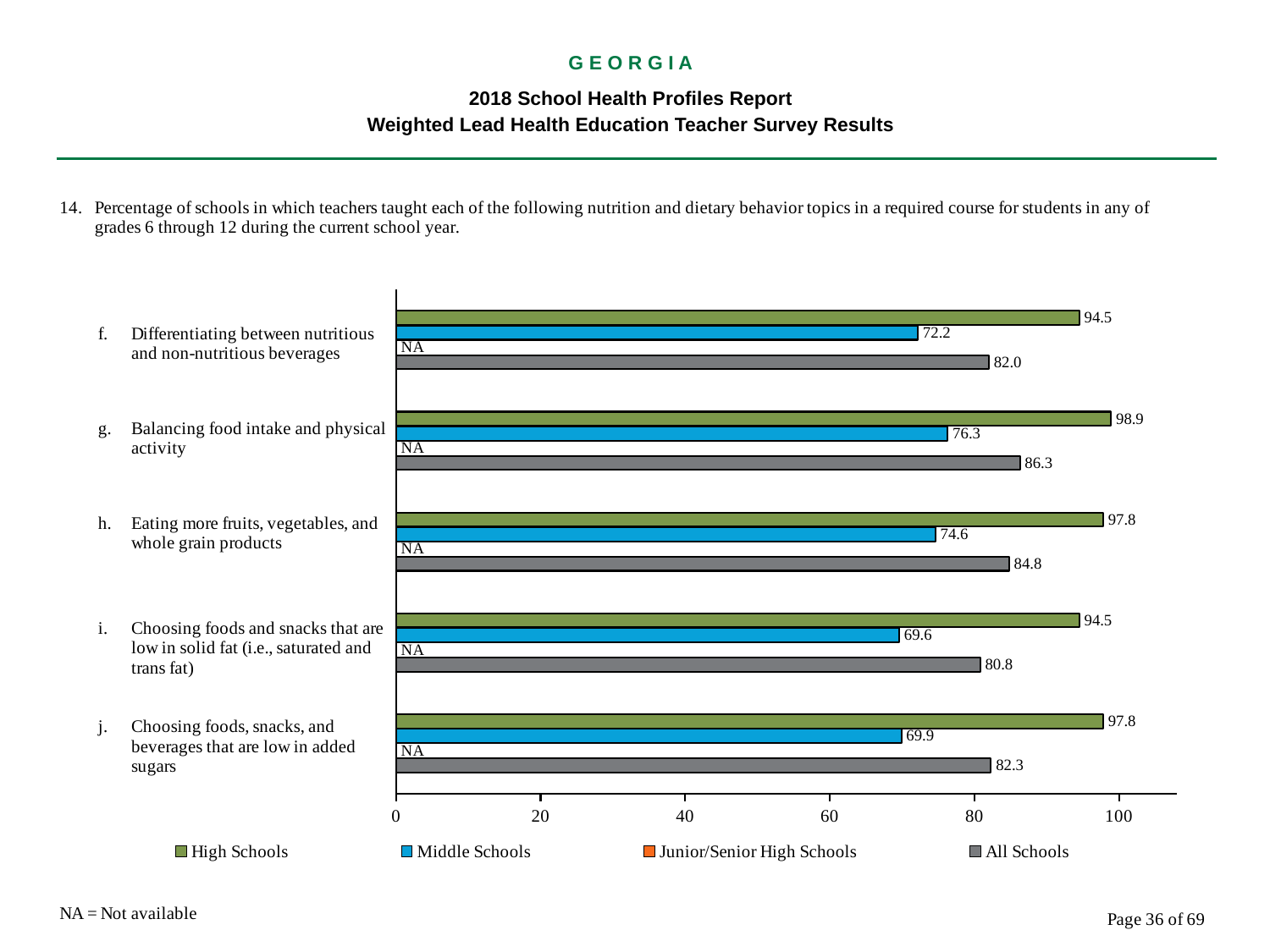
What kind of chart is shown on the slide? Bar chart How many topics (categories) are plotted on the chart? 5 What does NA stand for according to the note on the slide? Not available Which is larger: the All Schools value for 'Balancing food intake and physical activity' or the All Schools value for 'Differentiating between nutritious and non-nutritious beverages'? Balancing food intake and physical activity What is the Middle Schools value for 'Choosing foods and snacks that are low in solid fat (i.e., saturated and trans fat)'? 69.6 What is the difference between the High Schools and Middle Schools values for 'Choosing foods, snacks, and beverages that are low in added sugars'? 27.9 Which topic has the lowest Middle Schools value? Choosing foods and snacks that are low in solid fat (i.e., saturated and trans fat) Which topic has the highest High Schools value? Balancing food intake and physical activity What is the High Schools value for 'Balancing food intake and physical activity'? 98.9 What is shown for Junior/Senior High Schools for 'Differentiating between nutritious and non-nutritious beverages'? NA What is the All Schools value for 'Eating more fruits, vegetables, and whole grain products'? 84.8 How many series does the legend list? 4